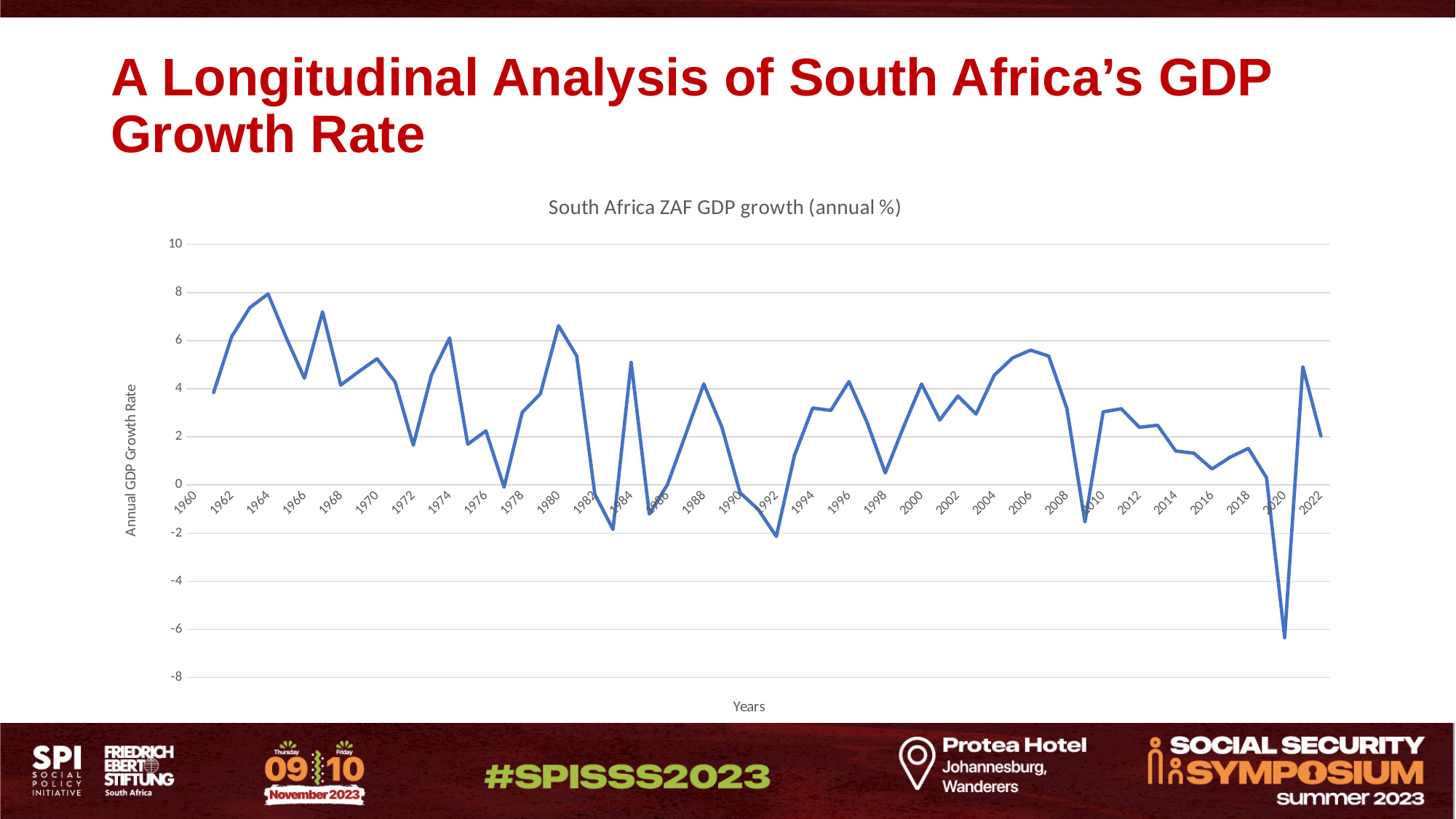
What kind of chart is shown on the slide? line chart Is the GDP growth rate for 1964 greater or less than 6? greater Is the GDP growth rate for 2020 greater or less than -4? less What is the label on the vertical axis of the chart? Annual GDP Growth Rate Is the GDP growth rate for 1992 greater or less than 0? less Which year has the higher GDP growth rate, 2009 or 2021? 2021 Overall, does the GDP growth rate tend to rise or fall from 1960 to 2022? fall In which year does the GDP growth rate reach its highest point? 1964 Which year has the higher GDP growth rate, 1980 or 1992? 1980 In which year does the GDP growth rate reach its lowest point? 2020 What is the title of the chart? South Africa ZAF GDP growth (annual %)